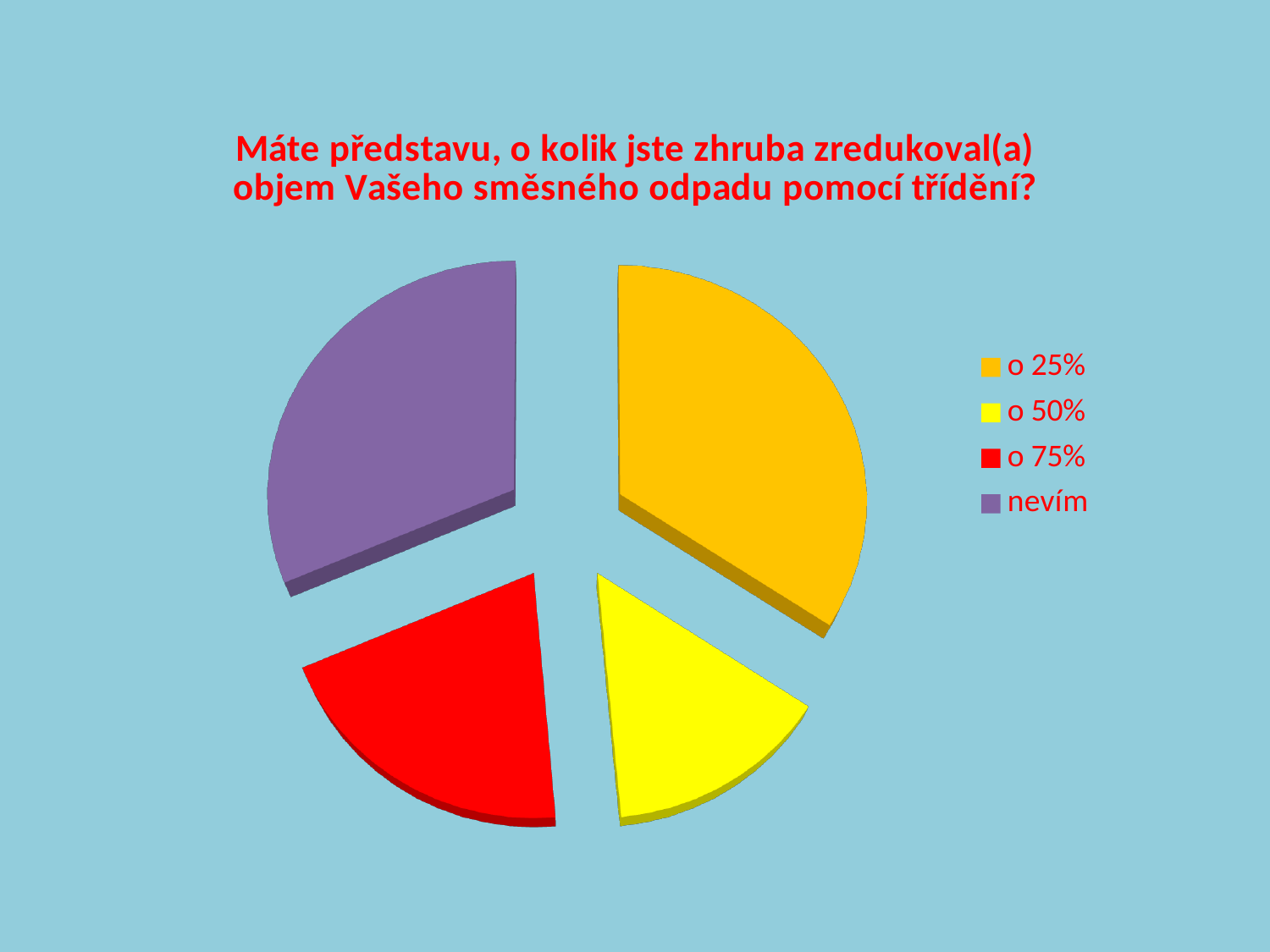
What kind of chart is shown on the slide? pie chart Which slice is larger, "o 25%" or "o 50%"? o 25% Which slice is larger, "nevím" or "o 75%"? nevím What is the title of the chart? Máte představu, o kolik jste zhruba zredukoval(a) objem Vašeho směsného odpadu pomocí třídění? Which slice is larger, "nevím" or "o 50%"? nevím What colour is the slice for "nevím"? purple Which category has the smallest slice of the pie? o 50% How many slices does the pie chart have? 4 How many entries does the legend list? 4